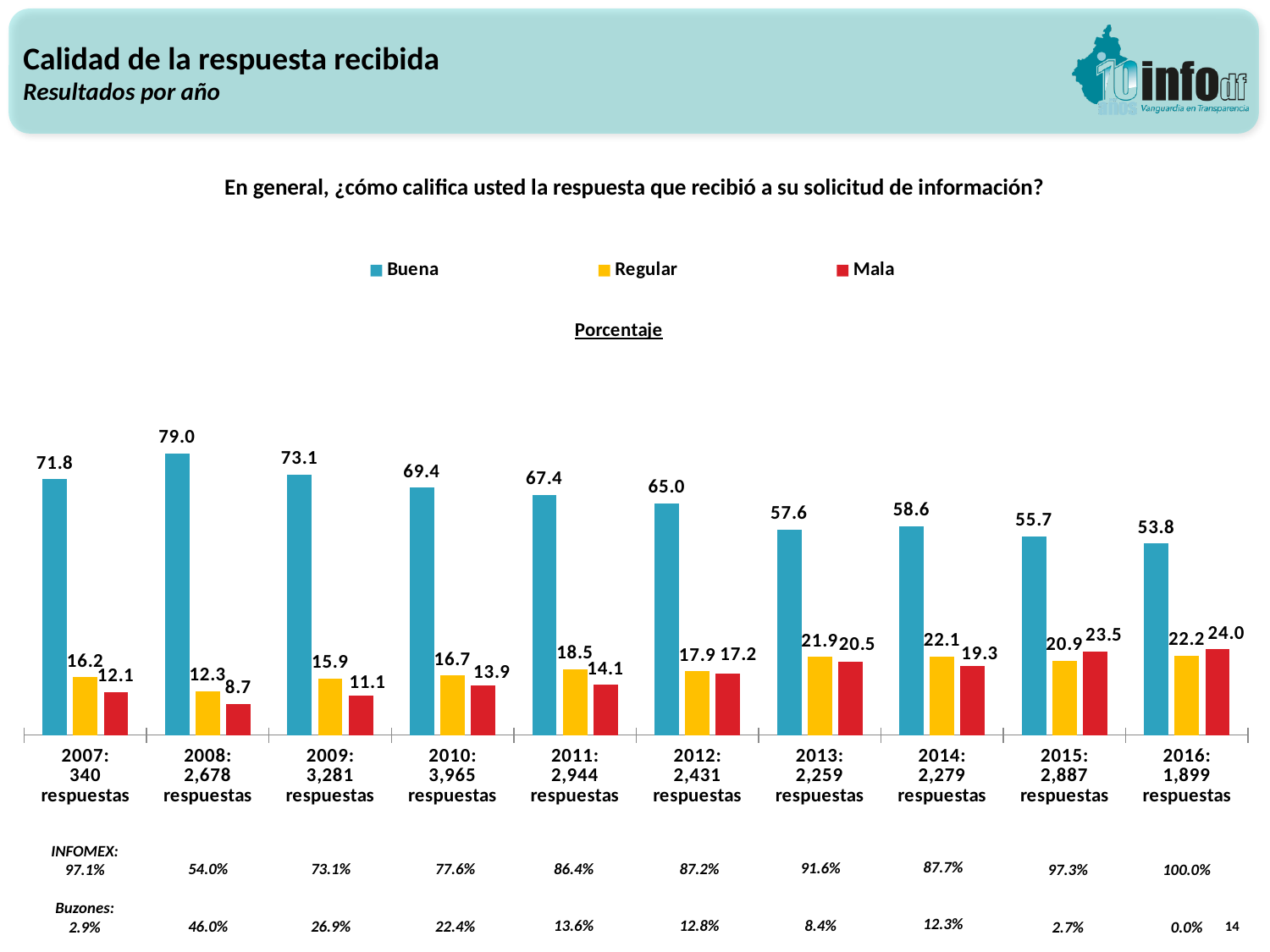
How many series does the legend list? 3 What kind of chart is shown on the slide? Bar chart In which year is the Buena value lowest? 2016 Do the Buena values rise or fall from 2008 to 2013? Fall In which year is the Buena value highest? 2008 What is the difference between the Buena values for 2008 and 2007? 7.2 What is the Buena value for 2008? 79.0 For 2015, which is larger: the Regular value or the Mala value? Mala What is the Regular value for 2013? 21.9 What is the Mala value for 2016? 24.0 How many years are shown on the x axis? 10 What is the difference between the Mala and Regular values for 2016? 1.8